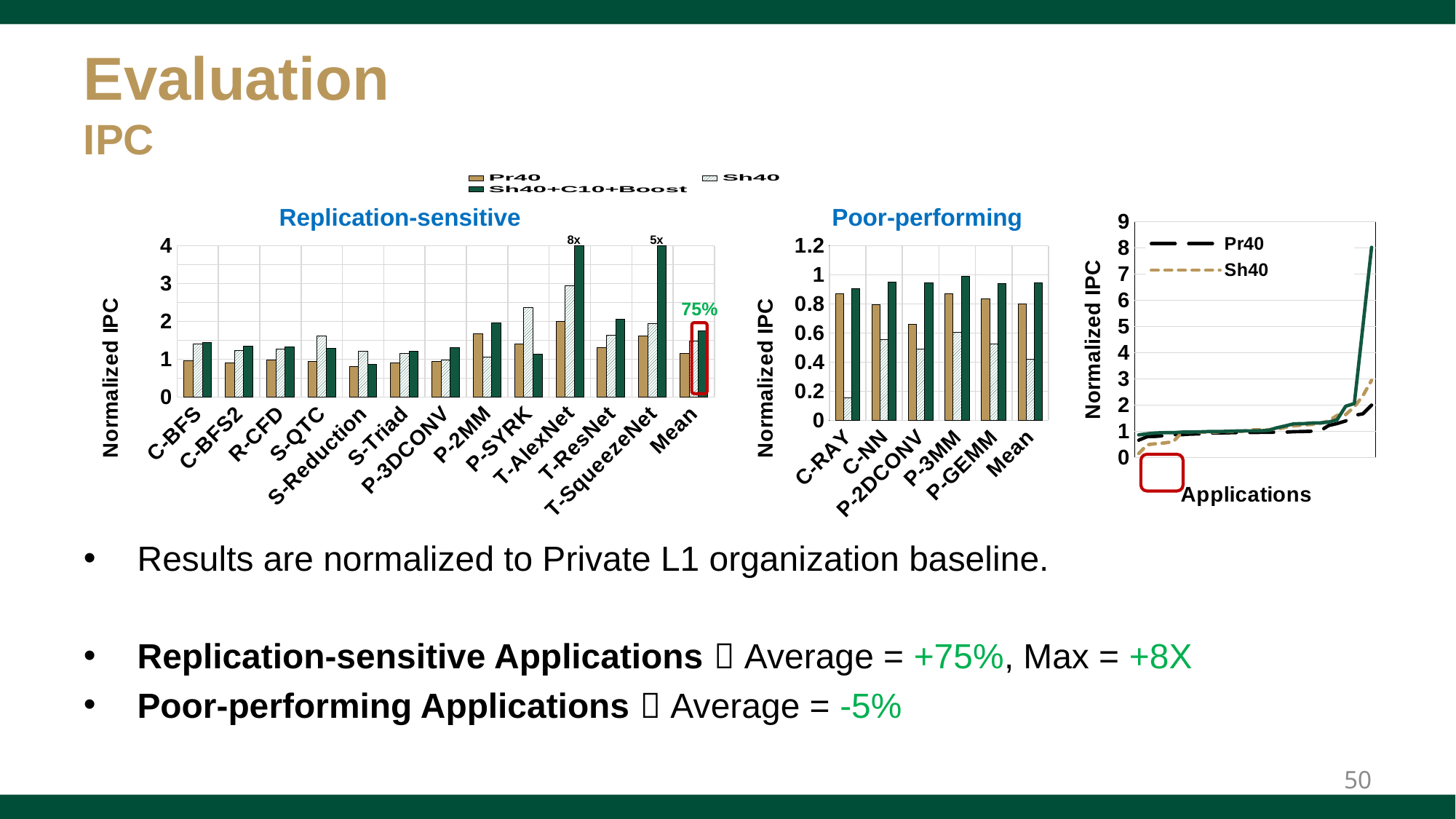
How many application categories are shown on the x axis of the Poor-performing chart? 6 How many series does the legend above the bar charts list? 3 In the Replication-sensitive chart, which application has the highest Sh40+C10+Boost value? T-AlexNet In the Replication-sensitive chart, what data label is printed above the Sh40+C10+Boost bar for T-SqueezeNet? 5x In the Poor-performing chart, is the Sh40 value for C-RAY greater or less than 0.4? less How many series does the legend of the rightmost line chart list? 2 What kind of chart is the rightmost chart with the Applications x axis? line chart In the rightmost line chart, do the values rise or fall along the x axis? rise How many application categories are shown on the x axis of the Replication-sensitive chart? 13 In the Replication-sensitive chart, is the Sh40 value for P-SYRK greater or less than 2? greater What kind of chart is the Replication-sensitive chart? bar chart In the Poor-performing chart, which is larger for C-NN: the Pr40 value or the Sh40 value? Pr40